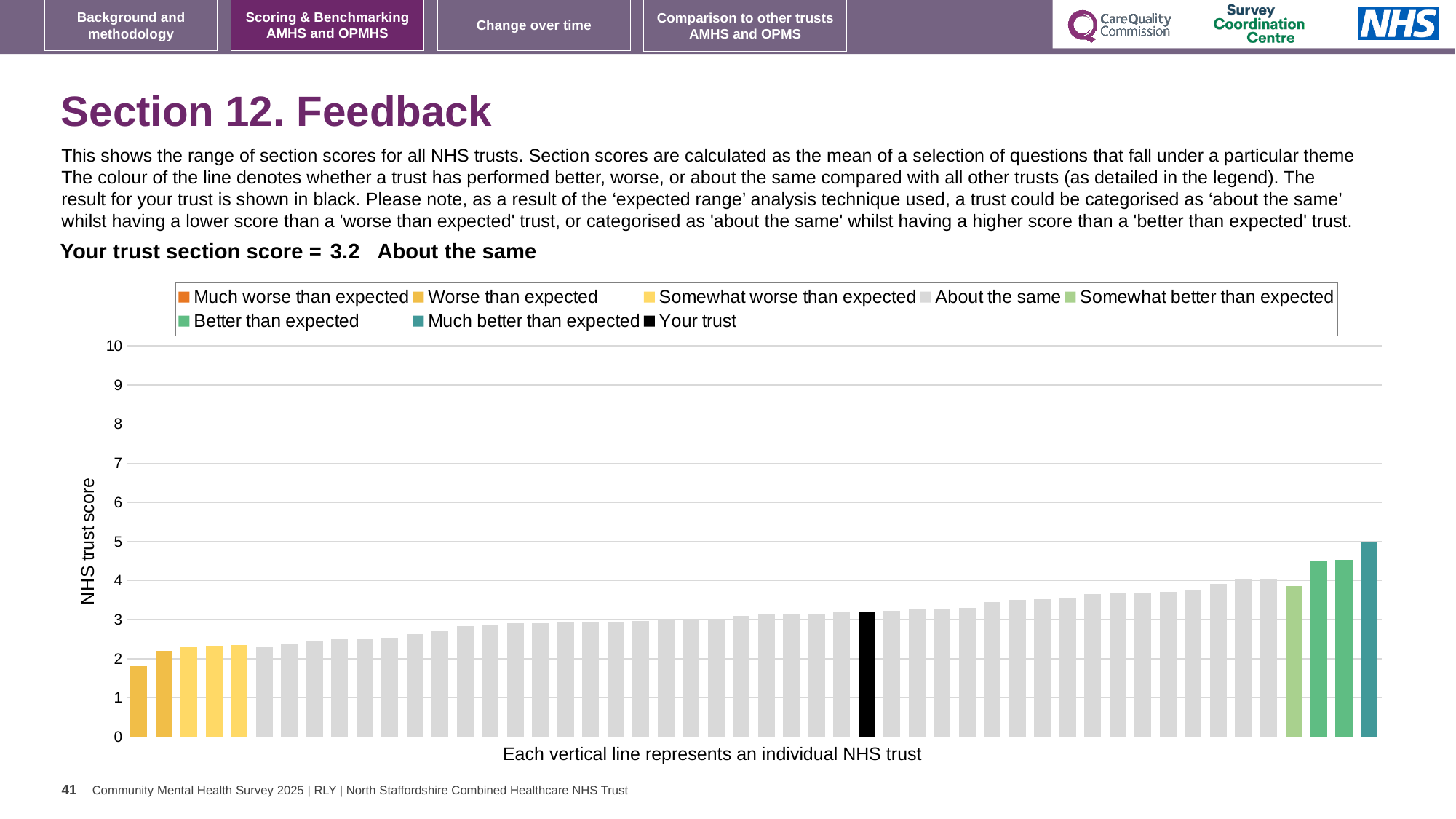
Is the value for the tallest bar greater or less than 4? greater What is the label on the y axis of the chart? NHS trust score What kind of chart is shown on the slide? bar chart Which legend category does the tallest bar belong to? Much better than expected Do the bar values rise or fall from left to right along the x axis? rise What is your trust's section score for Section 12. Feedback? 3.2 Which category is your trust placed in for Section 12. Feedback? About the same What colour is used for 'Your trust' in the chart? black How many entries does the chart legend list? 8 Is the value for the shortest bar greater or less than 2? less How many bars are coloured as 'Much better than expected'? 1 Is the value for your trust greater or less than 3? greater